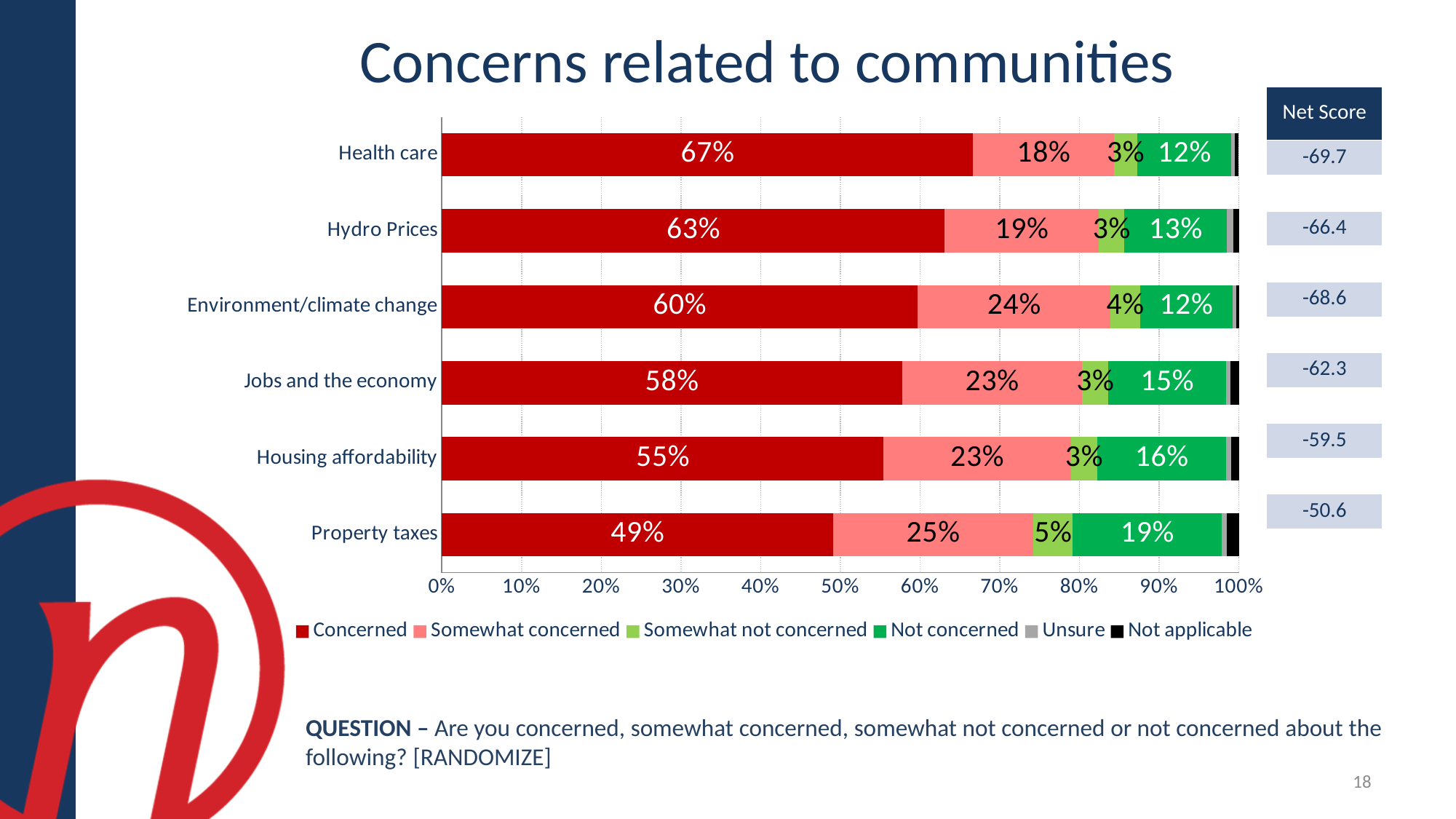
Which category has the highest Concerned percentage? Health care What is the difference between the Concerned percentage for Health care and for Property taxes? 18 percentage points Which category has the lowest Concerned percentage? Property taxes Which has a larger Concerned percentage, Hydro Prices or Jobs and the economy? Hydro Prices What is the title of the chart? Concerns related to communities How many categories are shown on the chart? 6 How many series does the legend list? 6 What type of chart is shown on the slide? Stacked bar chart What is the Somewhat concerned value for Environment/climate change? 24% What percentage of respondents are Concerned about Health care? 67% What is the Somewhat not concerned value for Jobs and the economy? 3% What is the Not concerned value for Property taxes? 19%